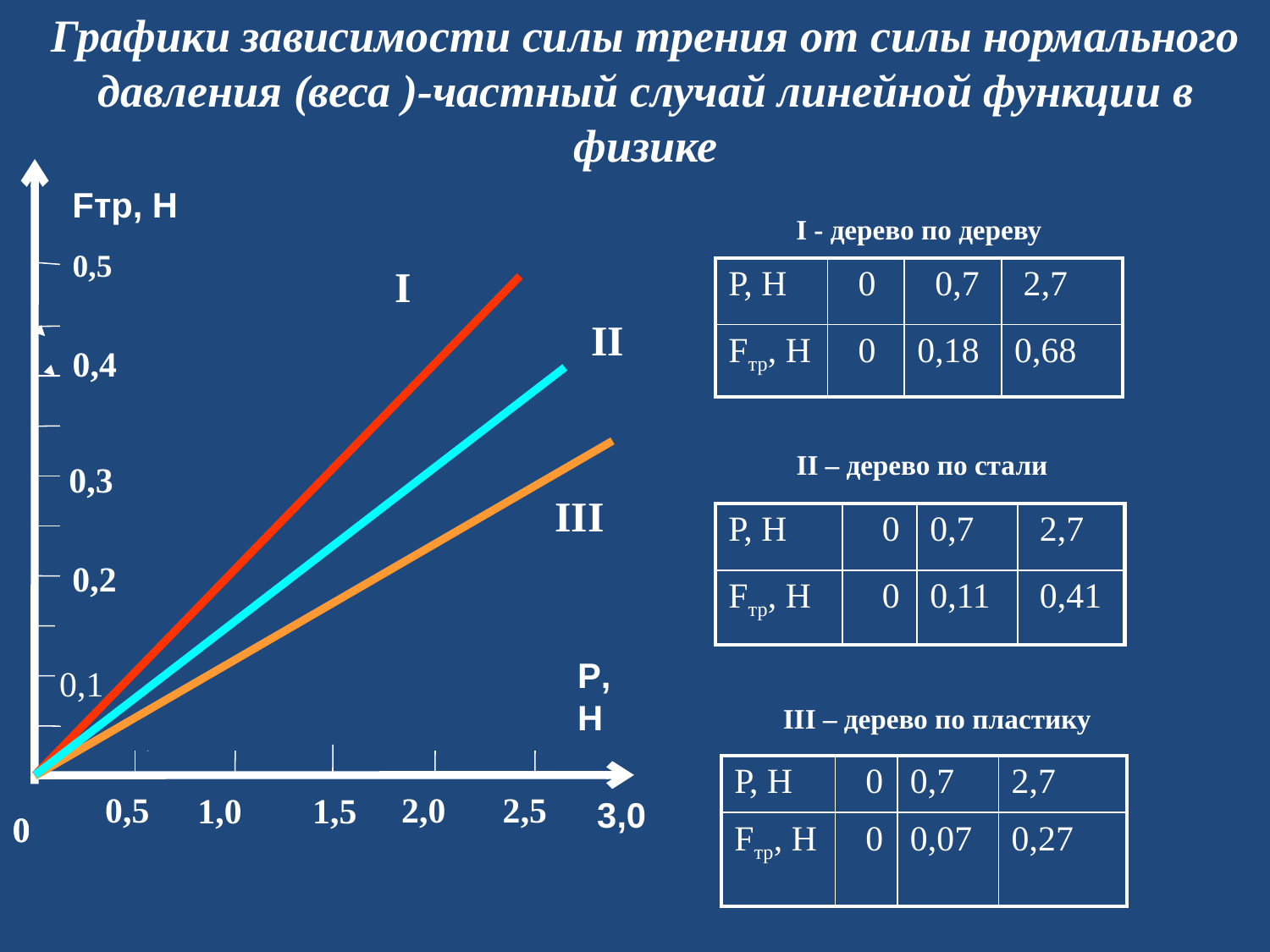
According to the table for line I (дерево по дереву), what is Fтр when P = 2,7 Н? 0,68 At P = 2,7 Н, which is larger: Fтр for line I or Fтр for line II? line I Do the values of Fтр rise or fall as P increases along the x axis? rise Which line on the chart rises most slowly? III Which line on the chart is the steepest? I What kind of chart is shown on the slide? line chart According to the table for line III (дерево по пластику), what is Fтр when P = 2,7 Н? 0,27 What is the difference between Fтр for line I and line III at P = 2,7 Н? 0,41 According to the table for line II (дерево по стали), what is Fтр when P = 0,7 Н? 0,11 What material pair does line II represent? дерево по стали How many lines are plotted on the chart? 3